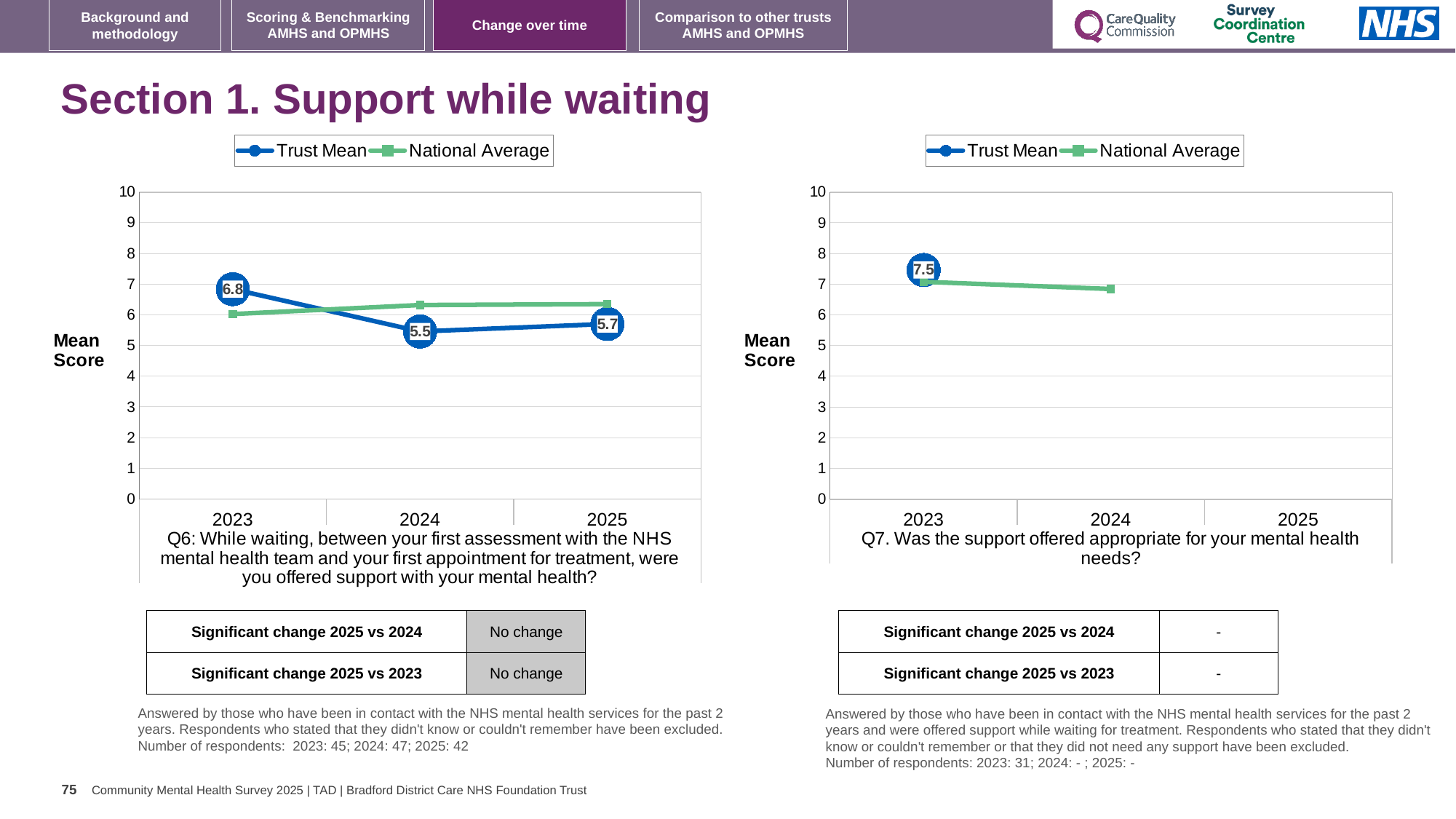
On the Q6 chart (left), which year has the highest Trust Mean score? 2023 On the Q7 chart (right), is the National Average for 2024 greater or less than 7? less On the Q6 chart (left), what is the Trust Mean score for 2023? 6.8 On the Q6 chart (left), is the Trust Mean for 2023 greater or less than the National Average for 2023? greater How many series does the legend of the Q6 chart (left) list? 2 On the Q7 chart (right), what is the Trust Mean score for 2023? 7.5 On the Q6 chart (left), which year has the lowest Trust Mean score? 2024 On the Q6 chart (left), is the National Average for 2025 greater or less than 6? greater What type of chart is the Q7 chart (right)? Line chart On the Q6 chart (left), what is the Trust Mean score for 2025? 5.7 On the Q6 chart (left), what is the Trust Mean score for 2024? 5.5 On the Q6 chart (left), what is the difference between the Trust Mean scores for 2023 and 2024? 1.3